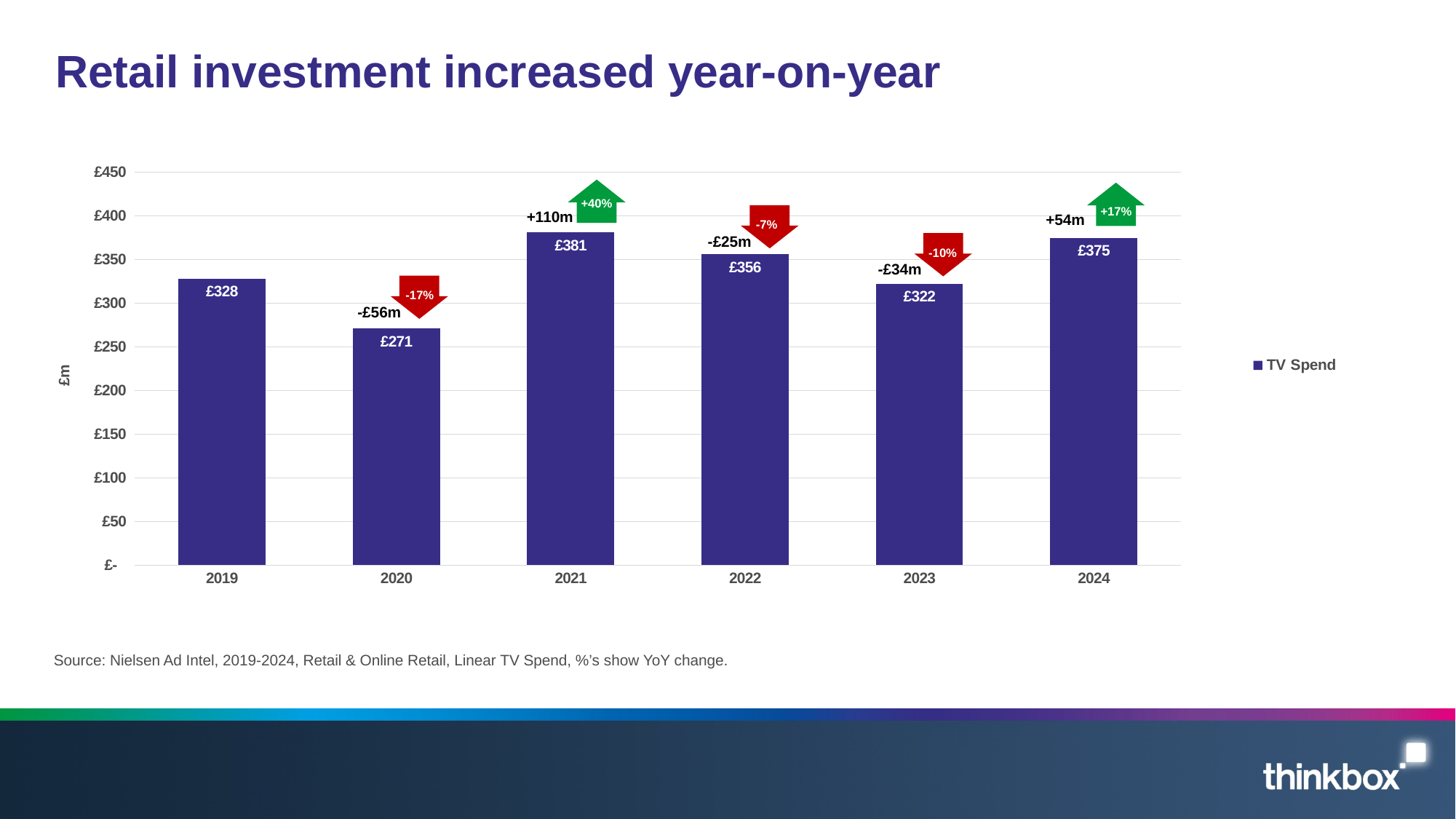
Which year has the highest TV Spend? 2021 What is the TV Spend value for 2024? £375 Which year has a larger TV Spend, 2022 or 2023? 2022 Which year has the lowest TV Spend? 2020 What year-on-year percentage change is shown above the 2021 bar? +40% What is the label of the y axis? £m What kind of chart is shown on the slide? Bar chart What is the TV Spend value for 2019? £328 How many years are shown on the x axis? 6 What is the TV Spend value for 2021? £381 What is the difference in TV Spend between 2021 and 2020? £110 How many series does the legend list? 1